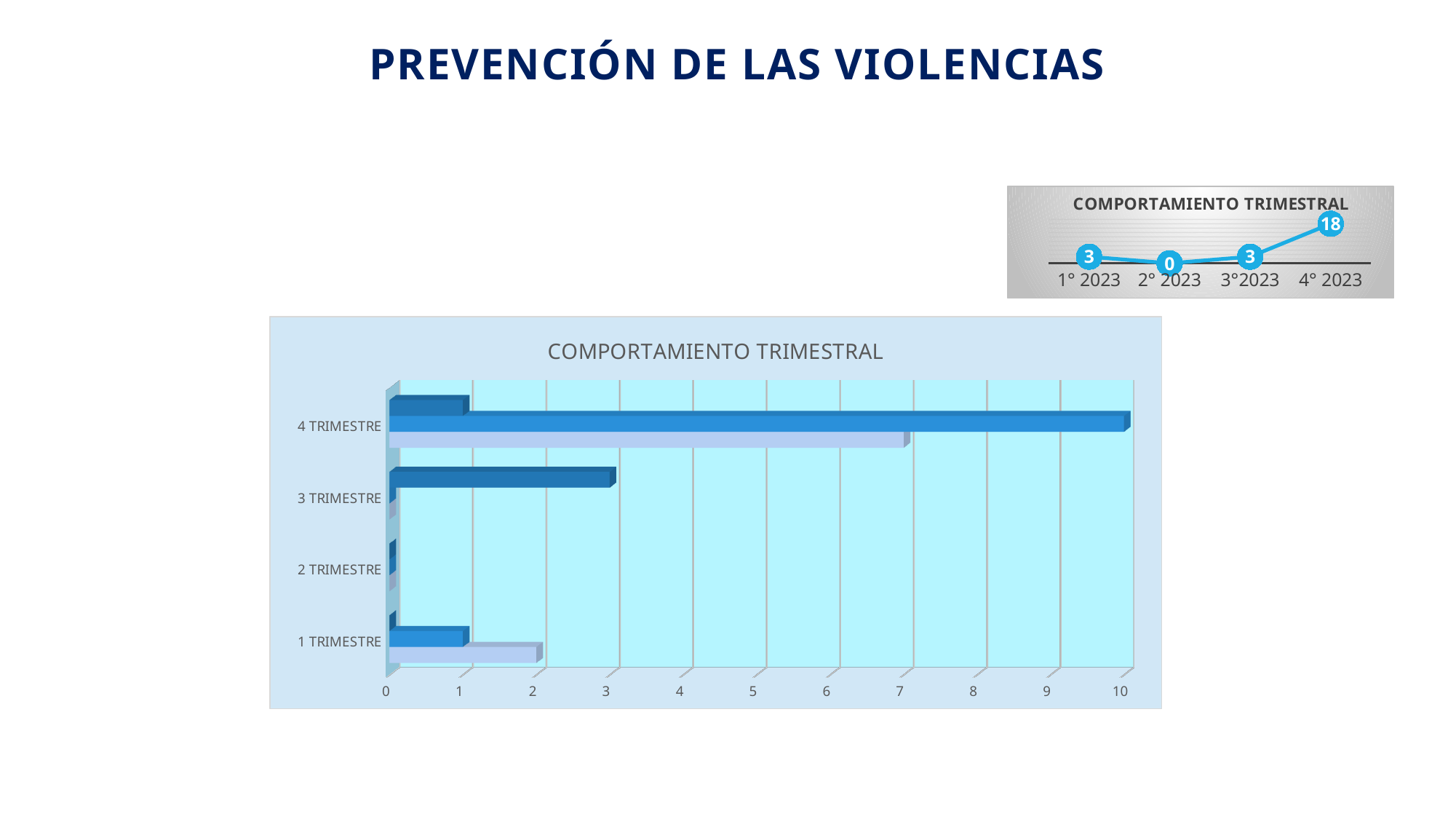
What kind of chart is the small chart at the top right of the slide? Line chart In the bar chart at the bottom left, which category has the longest bar? 4 TRIMESTRE In the line chart at the top right, what is the value for 2° 2023? 0 In the line chart at the top right, which period has the highest value? 4° 2023 In the line chart at the top right, what is the value for 4° 2023? 18 What kind of chart is the large chart at the bottom left of the slide? Bar chart In the line chart at the top right, how many data points are plotted? 4 In the line chart at the top right, which period has the lowest value? 2° 2023 In the line chart at the top right, what is the value for 1° 2023? 3 In the line chart at the top right, what is the difference between the values for 4° 2023 and 3°2023? 15 In the bar chart at the bottom left, is the longest bar for 4 TRIMESTRE greater or less than 9? greater In the bar chart at the bottom left, how many categories are shown on the vertical axis? 4